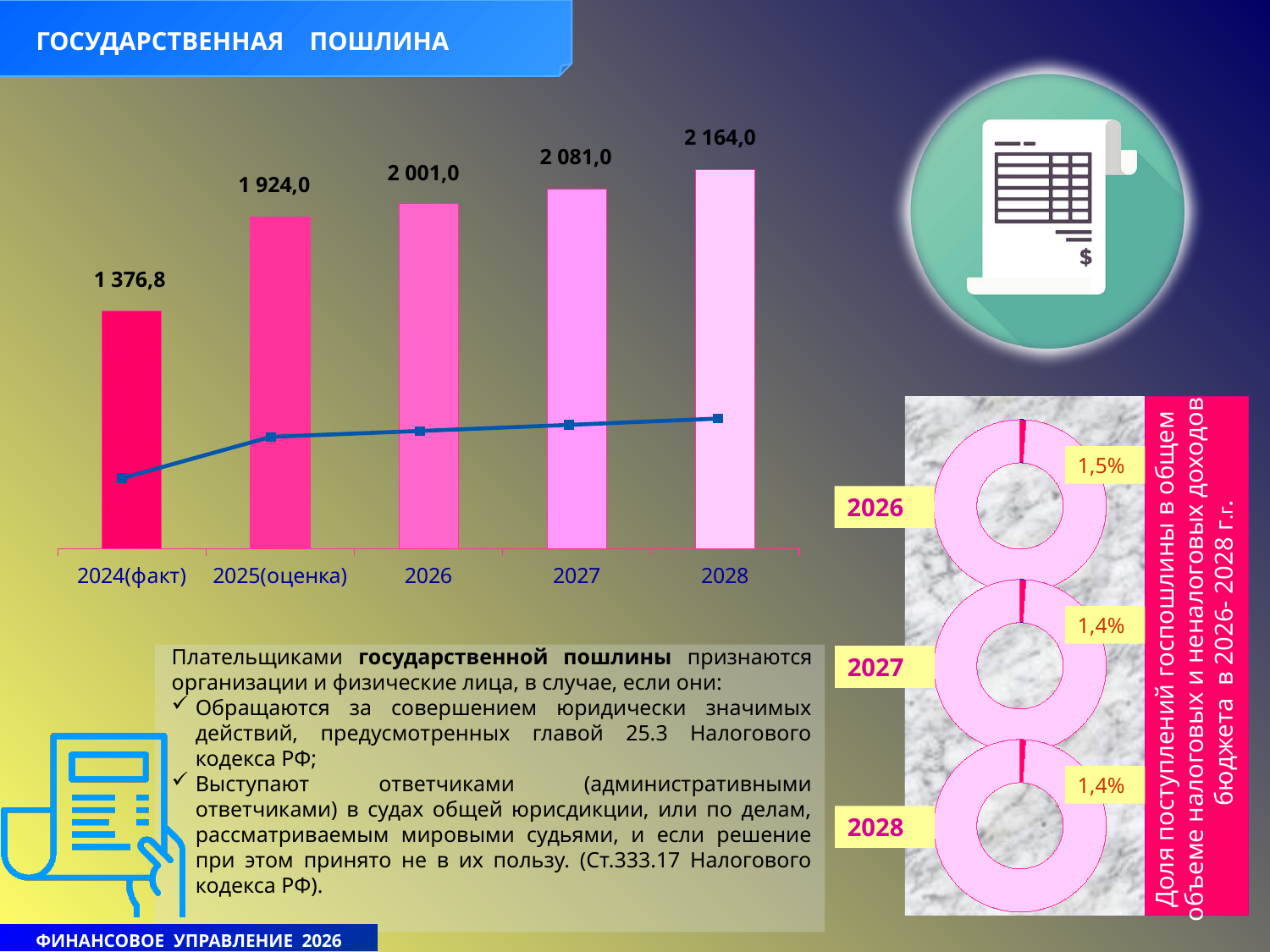
In the donut charts on the right, what share is shown for 2028? 1,4% In the bar chart on the left, which category has the highest value? 2028 How many categories are shown on the x axis of the bar chart on the left? 5 In the bar chart on the left, what is the value for 2024(факт)? 1 376,8 In the bar chart on the left, which is larger: the value for 2026 or the value for 2025(оценка)? 2026 In the bar chart on the left, which category has the lowest value? 2024(факт) In the bar chart on the left, what is the value for 2027? 2 081,0 In the bar chart on the left, what is the value for 2025(оценка)? 1 924,0 In the bar chart on the left, what is the difference between the values for 2027 and 2026? 80,0 In the donut charts on the right, what share is shown for 2026? 1,5% In the bar chart on the left, what is the difference between the values for 2028 and 2024(факт)? 787,2 In the bar chart on the left, do the values rise or fall from 2024(факт) to 2028? rise